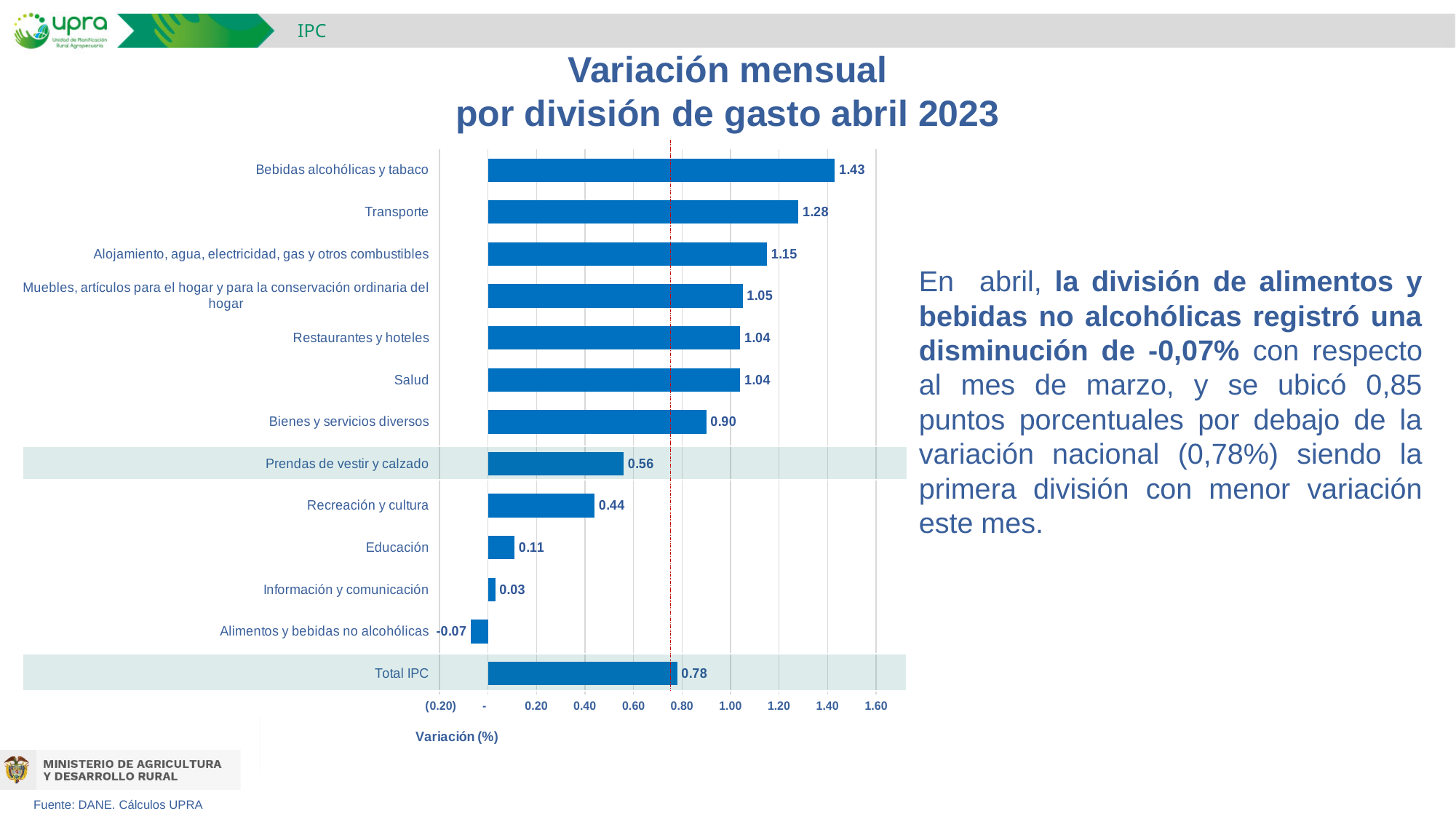
Which category has the highest value? Bebidas alcohólicas y tabaco How many categories are shown in the chart? 13 Which is larger, the value for Prendas de vestir y calzado or the value for Recreación y cultura? Prendas de vestir y calzado What is the label of the horizontal axis? Variación (%) What is the value for Transporte? 1.28 What is the value for Alimentos y bebidas no alcohólicas? -0.07 Is the value for Bienes y servicios diversos greater or less than 1.00? less What is the value for Educación? 0.11 Which category has the lowest value? Alimentos y bebidas no alcohólicas What is the value for Total IPC? 0.78 What kind of chart is shown on the slide? bar chart What is the difference between the values for Bebidas alcohólicas y tabaco and Transporte? 0.15